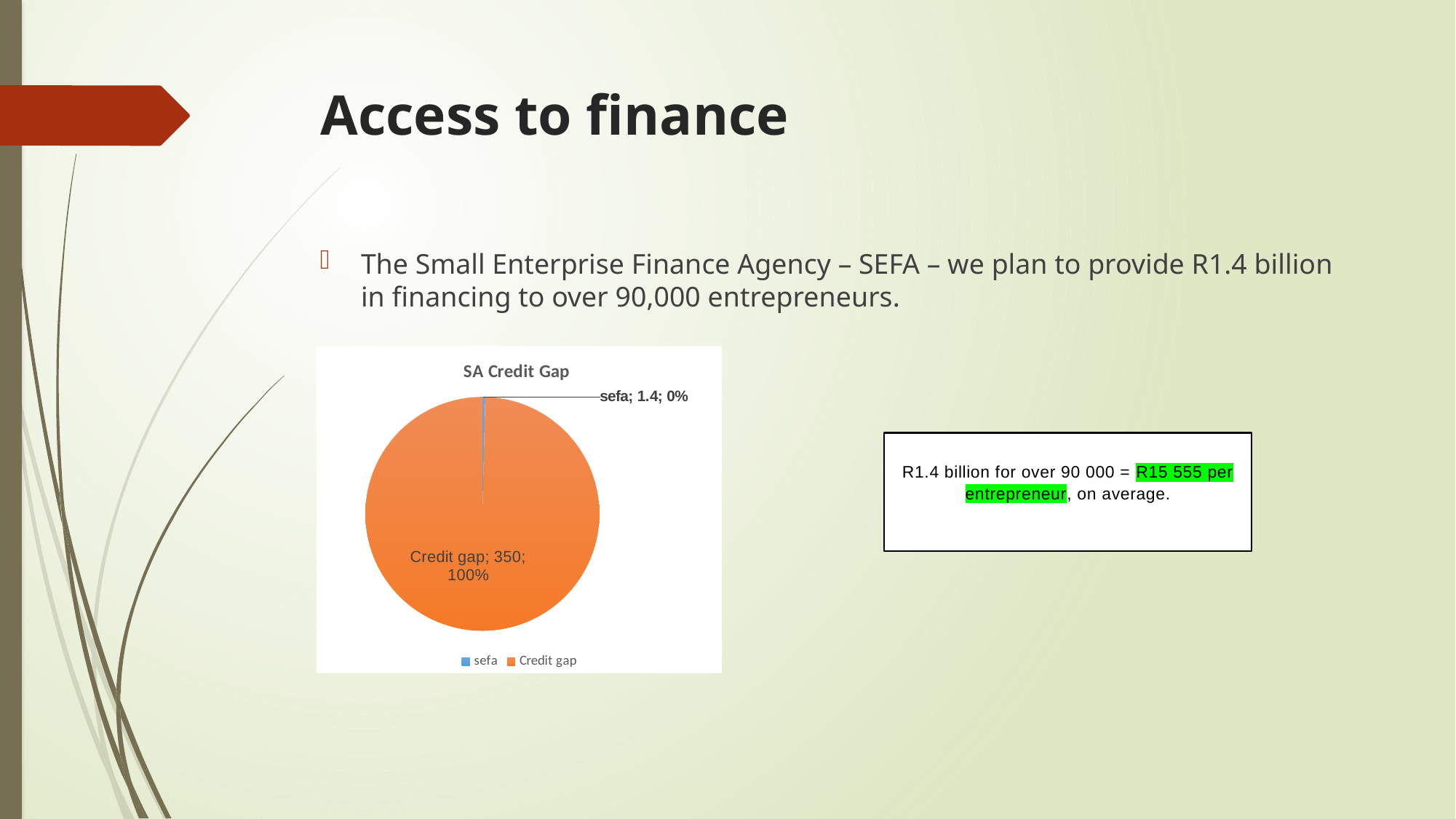
What percentage share does the sefa slice have in the pie chart? 0% What kind of chart is shown on the slide? pie chart Which slice is the largest in the SA Credit Gap pie chart? Credit gap What colour is the Credit gap slice in the pie chart? orange What percentage share does the Credit gap slice have in the pie chart? 100% Which is larger, the value for sefa or the value for Credit gap? Credit gap How many slices does the SA Credit Gap pie chart have? 2 What is the title of the chart? SA Credit Gap What is the difference between the Credit gap value and the sefa value? 348.6 What is the value for Credit gap in the SA Credit Gap chart? 350 What is the value for sefa in the SA Credit Gap chart? 1.4 Which slice is the smallest in the SA Credit Gap pie chart? sefa